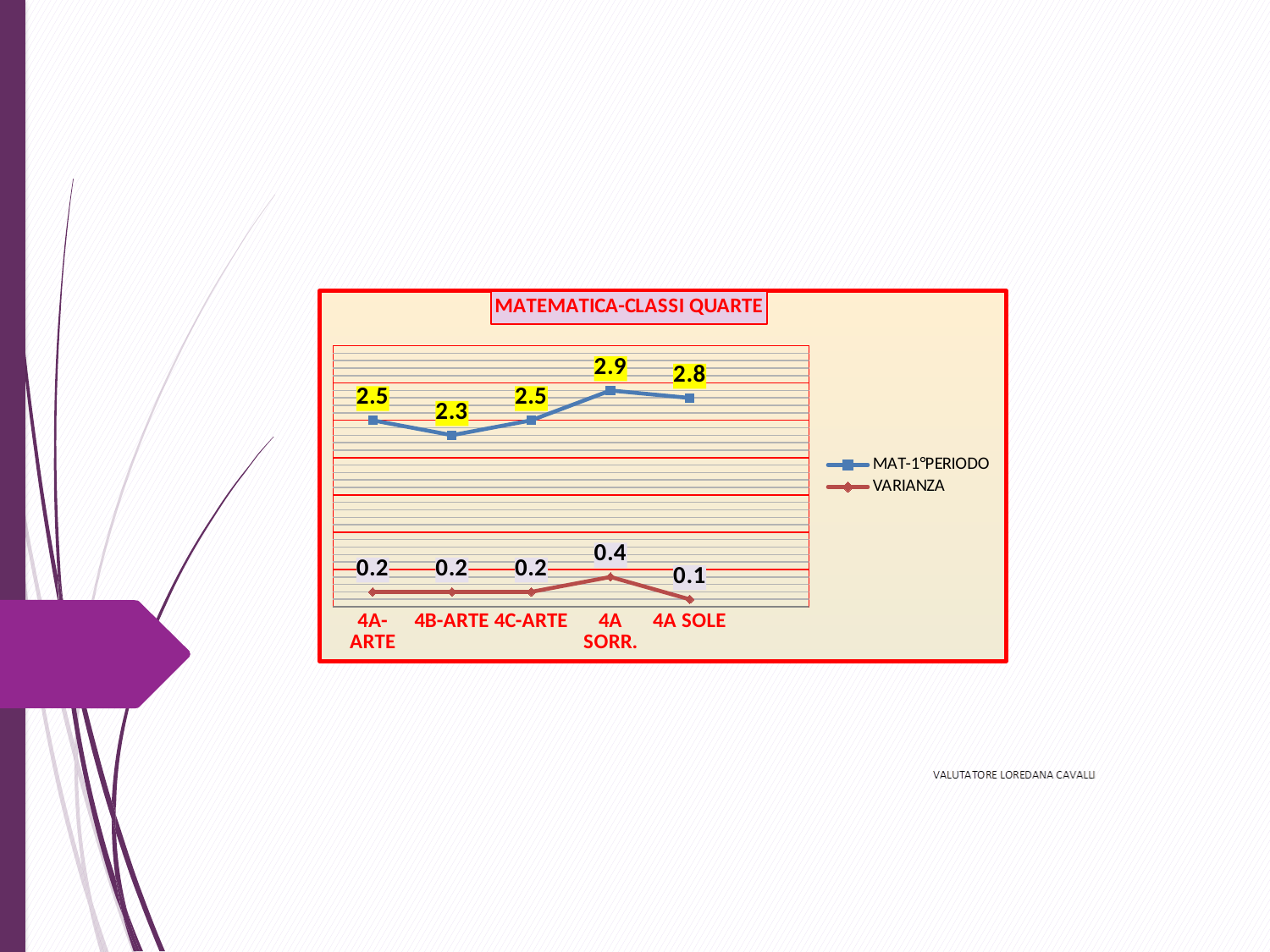
What is the MAT-1°PERIODO value for 4B-ARTE? 2.3 How many categories are shown on the x axis? 5 Which category has the highest MAT-1°PERIODO value? 4A SORR. What is the title of the chart? MATEMATICA-CLASSI QUARTE How many series does the legend list? 2 Which category has the lowest MAT-1°PERIODO value? 4B-ARTE Which is larger, the MAT-1°PERIODO value for 4A SOLE or for 4C-ARTE? 4A SOLE What is the VARIANZA value for 4A SOLE? 0.1 What is the difference between the MAT-1°PERIODO values for 4A SORR. and 4B-ARTE? 0.6 What is the MAT-1°PERIODO value for 4A SORR.? 2.9 Which category has the highest VARIANZA value? 4A SORR. What kind of chart is shown? Line chart